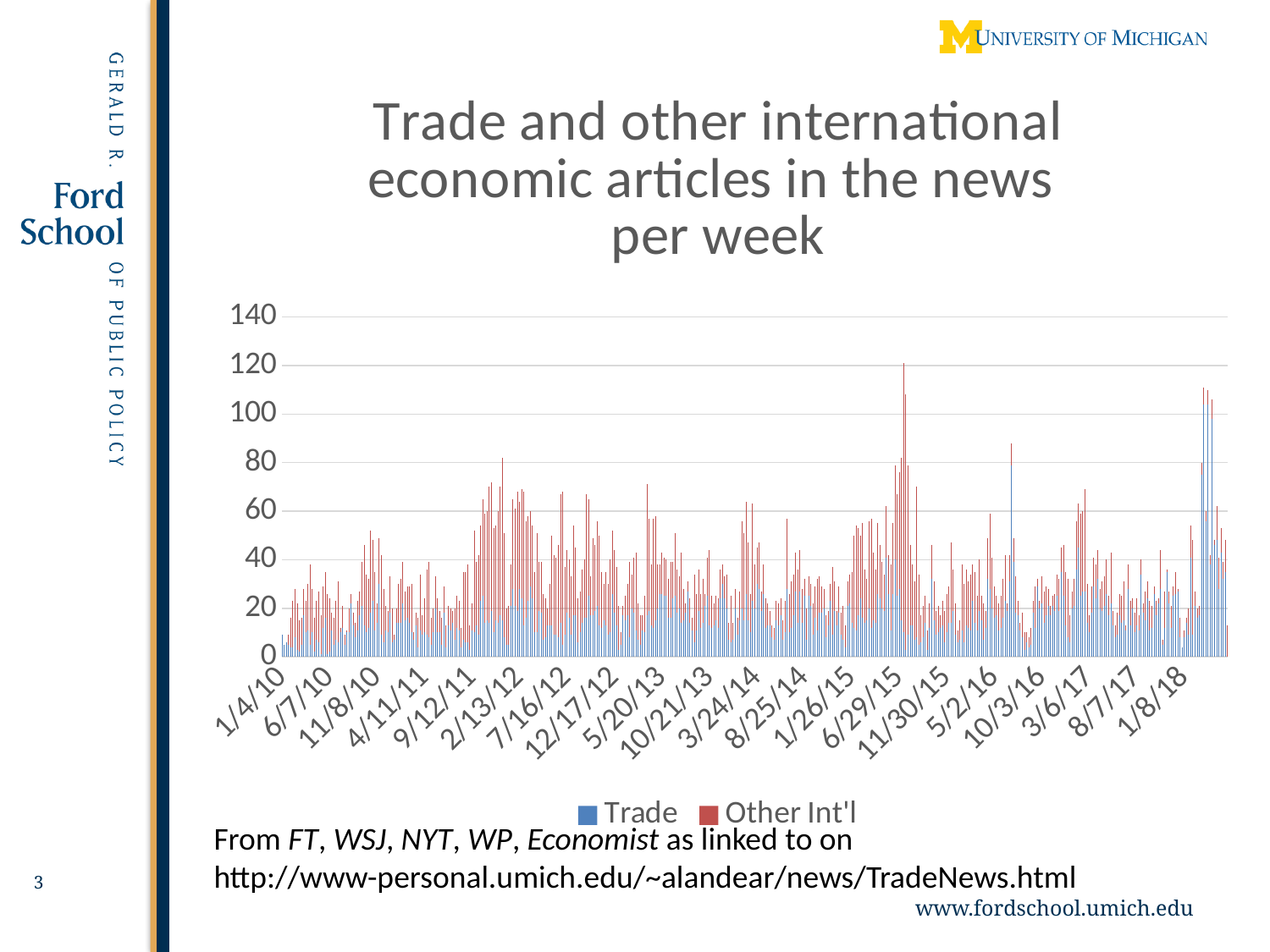
Is the value of the tallest bar on the chart greater or less than 100? greater How many date labels are shown along the x axis? 20 Is the value for the first week shown (1/4/10) greater or less than 60? less What are the two series named in the legend? Trade and Other Int'l What kind of chart is shown on the slide? bar chart Does any bar on the chart reach the 140 gridline? No How many series does the legend list? 2 Which series is drawn in red? Other Int'l